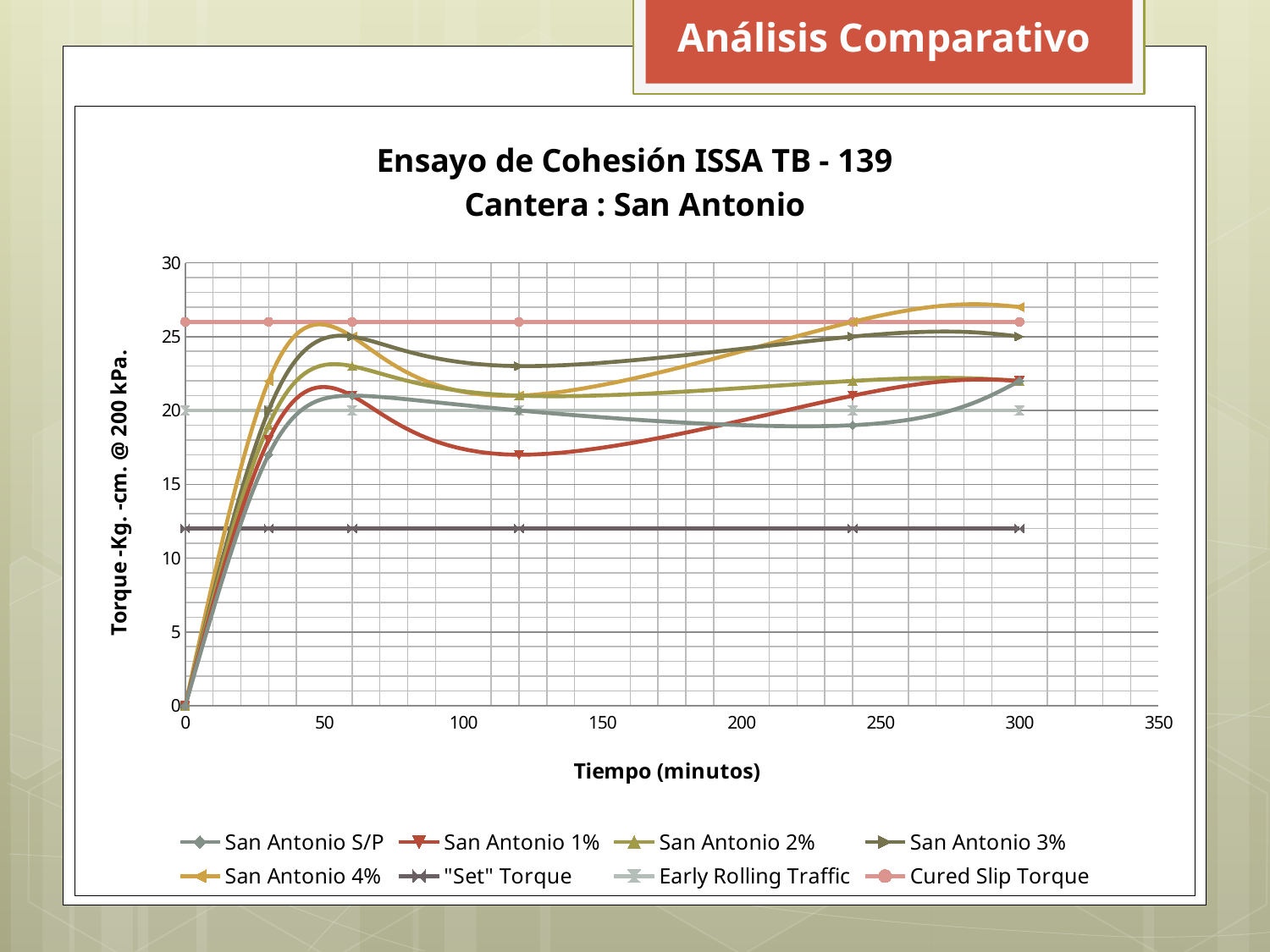
What constant value does the Early Rolling Traffic line sit at? 20 Is the value of the "Set" Torque line greater or less than 15? less Which San Antonio series has the highest value at 300 minutes? San Antonio 4% What kind of chart is shown on the slide? line chart Is the value for San Antonio 1% at 120 minutes greater or less than 20? less Is the value of the Cured Slip Torque line greater or less than 25? greater What is the title of the chart? Ensayo de Cohesión ISSA TB - 139 Cantera : San Antonio Does the San Antonio 1% line rise or fall between 60 and 120 minutes? fall What is the label of the x axis? Tiempo (minutos) At 120 minutes, which is larger: San Antonio 3% or San Antonio 1%? San Antonio 3% How many series does the legend list? 8